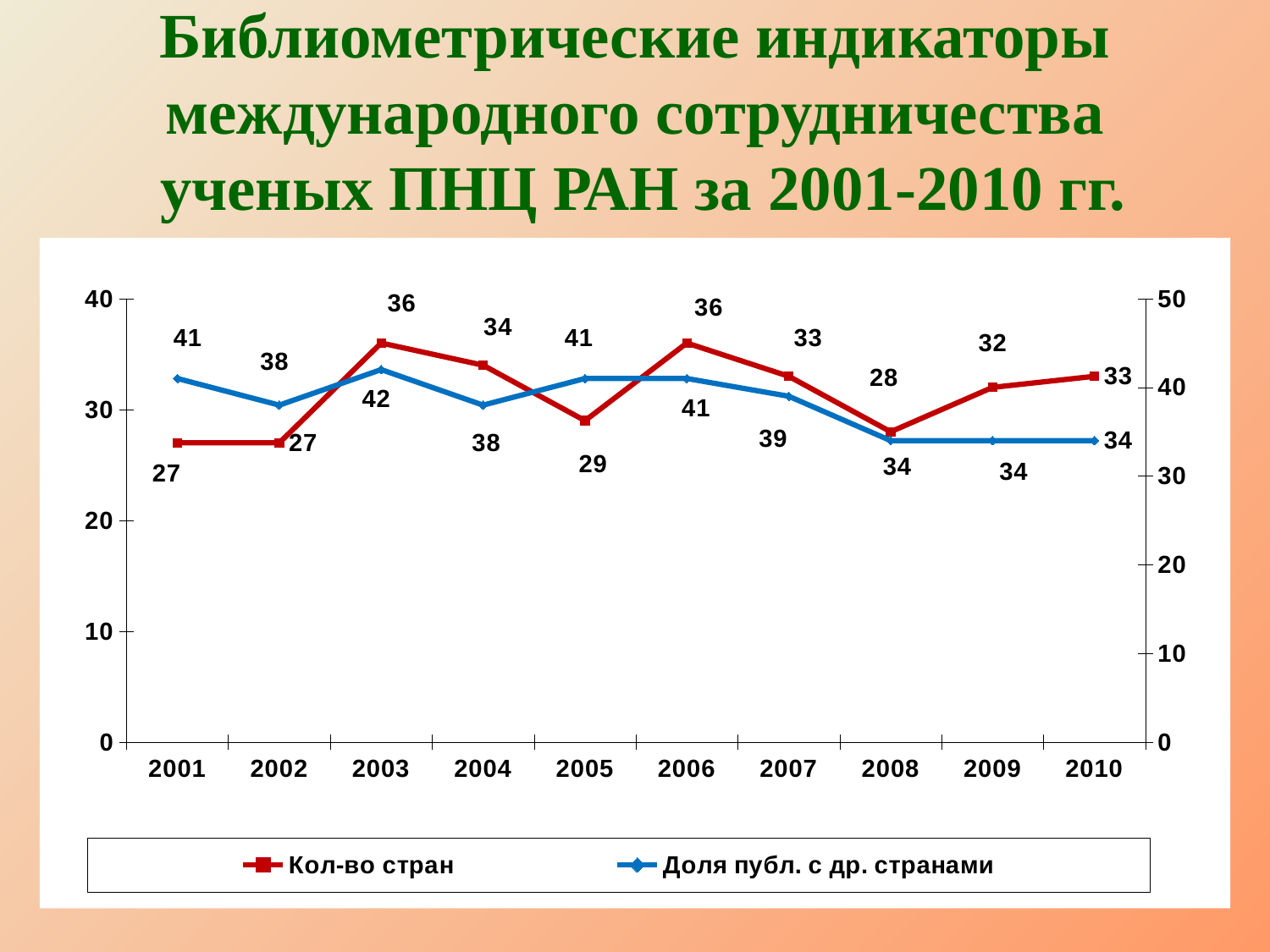
Which colour is used for the "Кол-во стран" series? Red What is the difference between the "Кол-во стран" values for 2003 and 2008? 8 Which is larger: "Доля публ. с др. странами" in 2002 or in 2007? 2007 What is the value of "Кол-во стран" in 2010? 33 What kind of chart is shown on the slide? Line chart How many series does the legend list? 2 What is the value of "Доля публ. с др. странами" in 2003? 42 How many years are shown on the x axis? 10 Does "Доля публ. с др. странами" rise or fall from 2007 to 2008? Fall In which year is "Доля публ. с др. странами" highest? 2003 In which year is "Кол-во стран" lowest? 2001 and 2002 What is the value of "Кол-во стран" in 2005? 29